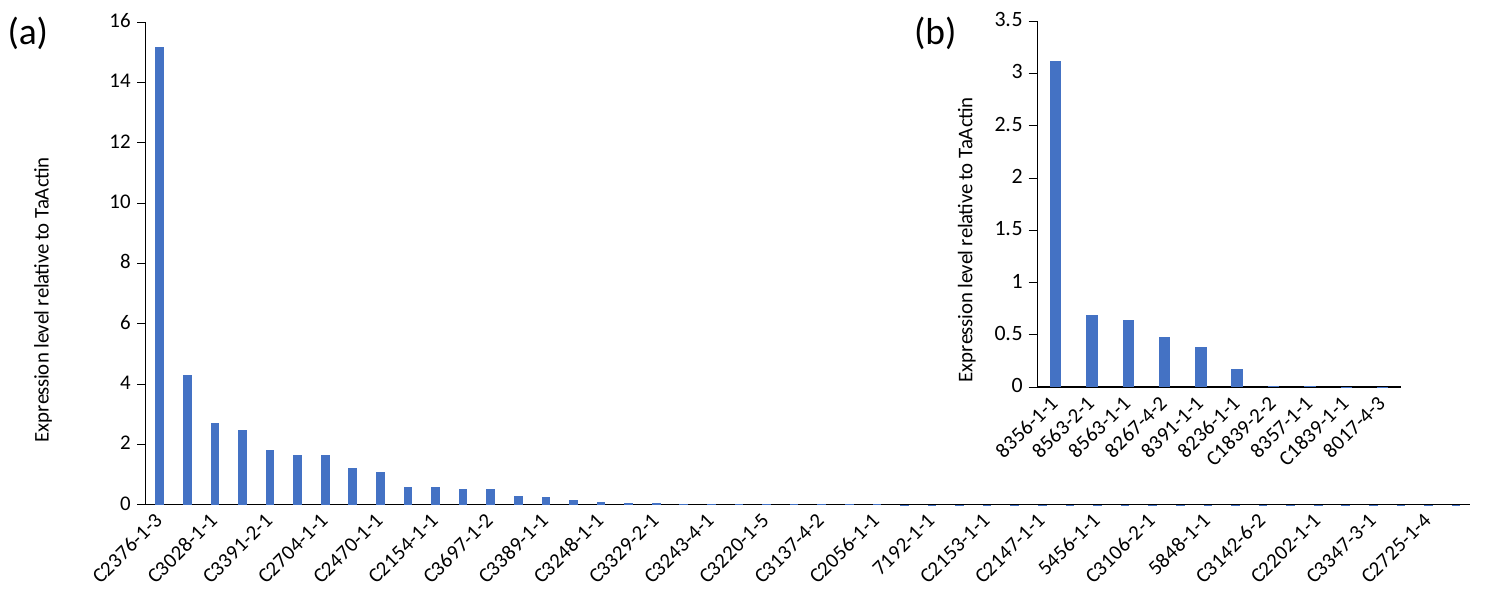
In chart (b), is the value for 8356-1-1 greater or less than 3? greater In chart (a), is the value for C2376-1-3 greater or less than 14? greater In chart (b), which category has the highest expression level? 8356-1-1 In chart (a), which category has the highest expression level? C2376-1-3 In chart (b), how many categories are shown on the x axis? 10 What is the y-axis title of chart (b)? Expression level relative to TaActin What kind of chart is chart (a)? bar chart In chart (b), is the value for 8391-1-1 greater or less than 0.5? less In chart (a), which is larger, the value for C3028-1-1 or the value for C3391-2-1? C3028-1-1 In chart (a), do the values rise or fall from left to right along the x axis? fall